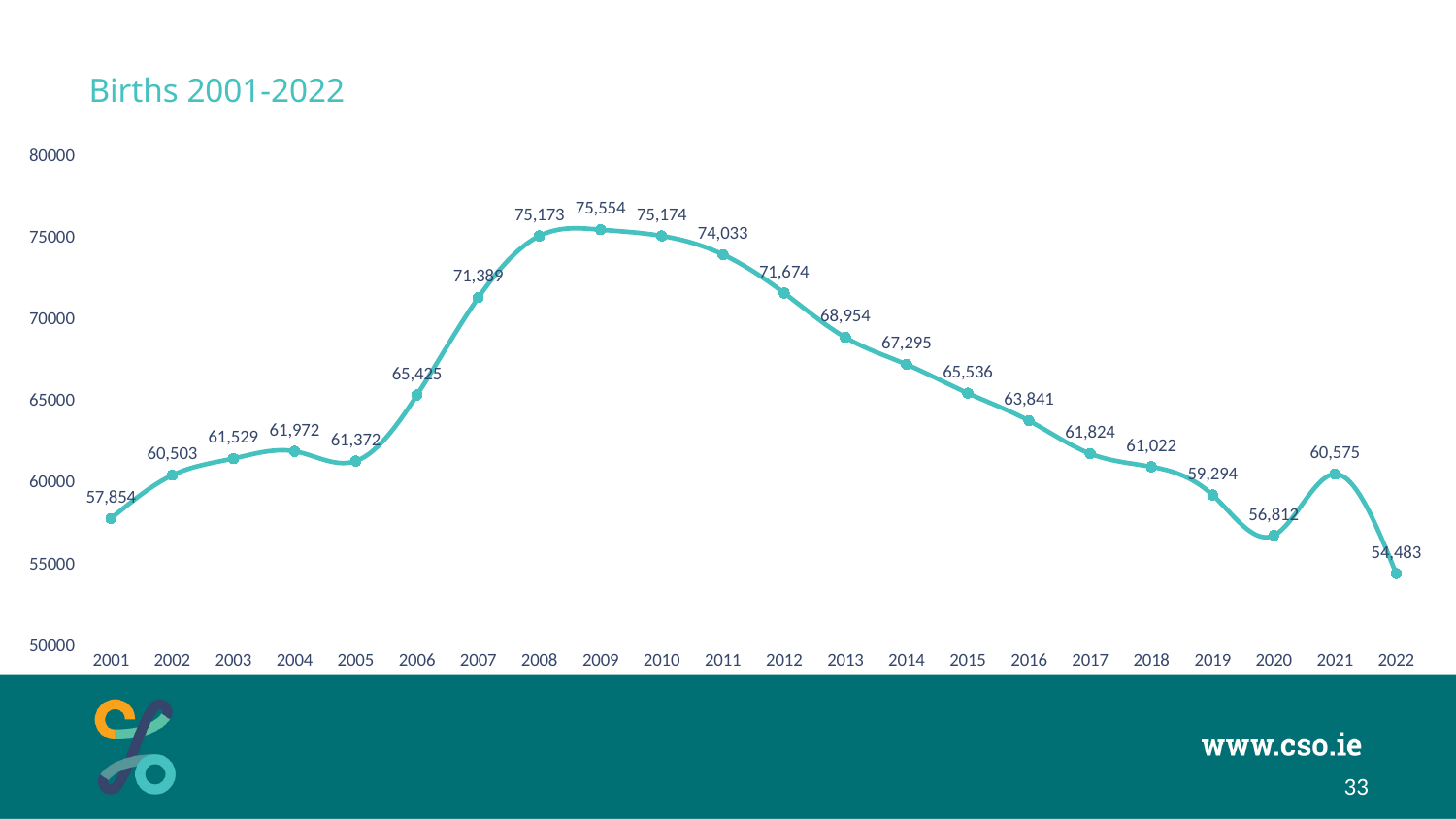
Do births rise or fall from 2009 to 2020? Fall What is the number of births in 2001? 57,854 What is the number of births in 2015? 65,536 What is the title of the chart? Births 2001-2022 What is the difference in births between 2021 and 2020? 3,763 How many years are plotted on the chart? 22 What is the number of births in 2022? 54,483 What type of chart is shown on the slide? Line chart Which year has the highest number of births? 2009 What is the number of births in 2009? 75,554 Which year has the lowest number of births? 2022 Which year had more births, 2006 or 2016? 2006